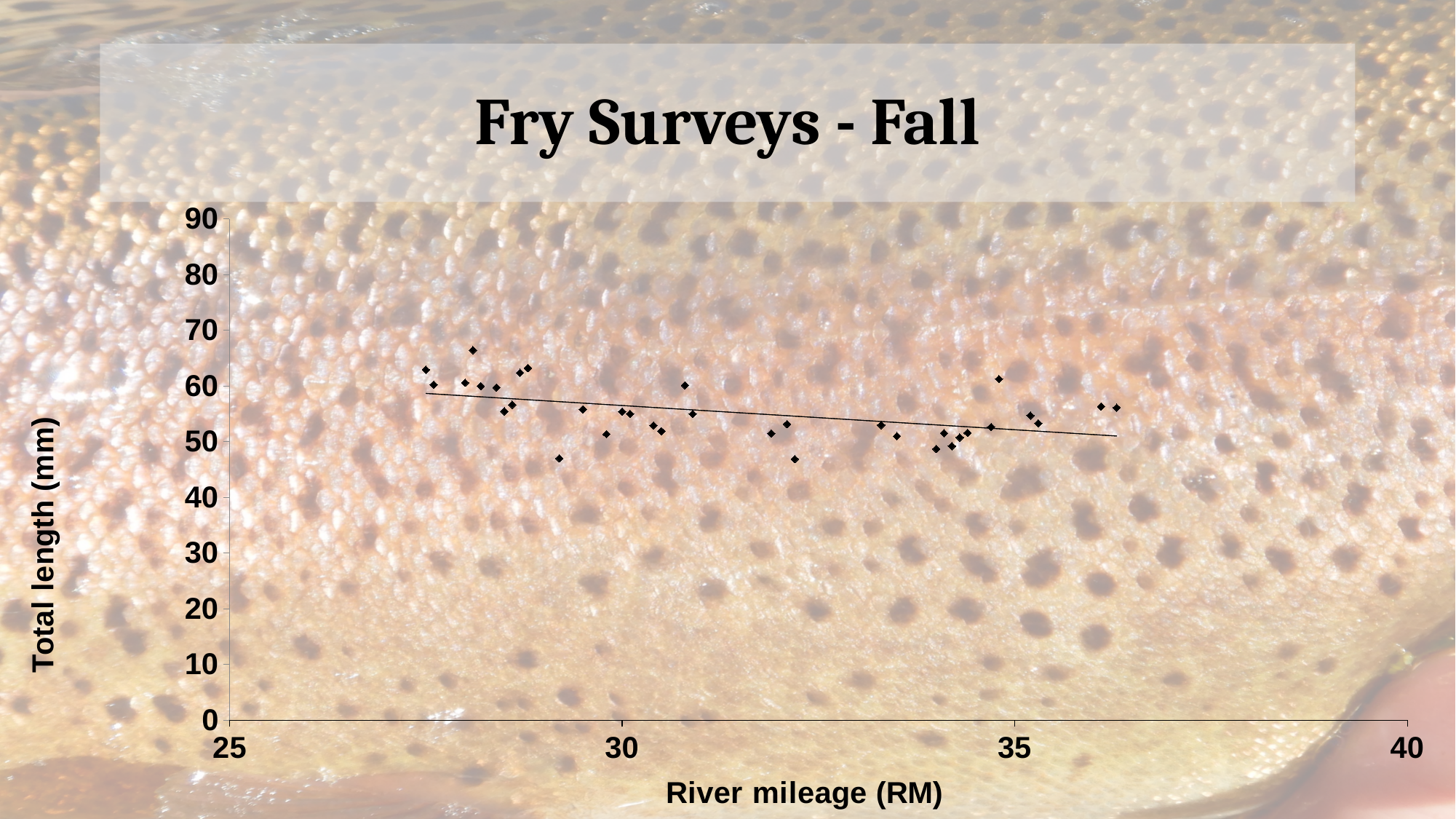
Is the river mileage of the leftmost plotted point greater or less than 25? greater Is the river mileage of the rightmost plotted point greater or less than 40? less What is the label of the vertical axis? Total length (mm) Is the highest plotted total length greater or less than 70? less What is the maximum value shown on the vertical axis? 90 What kind of chart is shown on the slide? scatter plot Does the trend line rise or fall as river mileage increases? fall What is the title of the chart? Fry Surveys - Fall